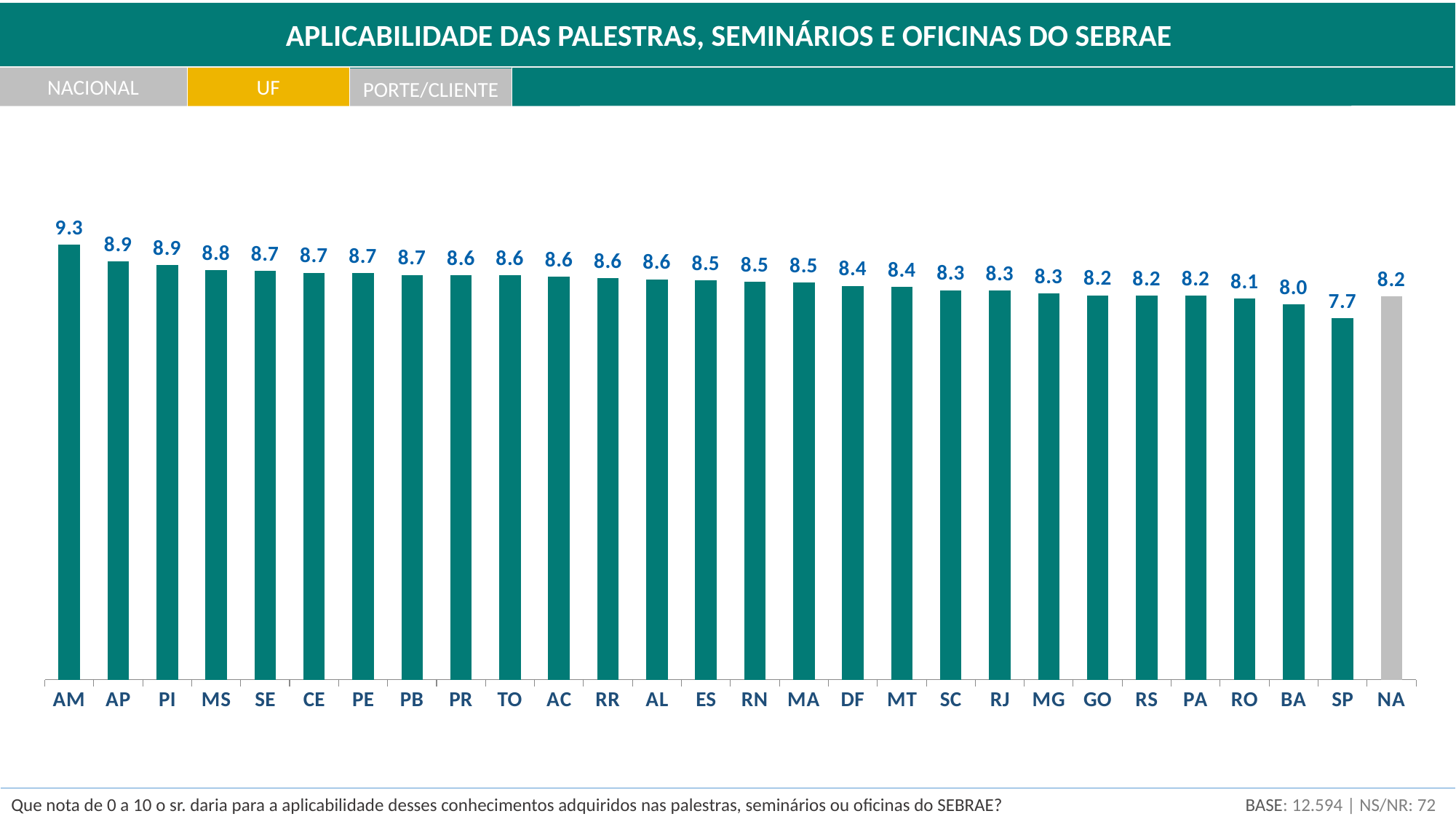
What is the value for AM? 9.3 What is the difference between the values for AP and BA? 0.9 How many bars are shown in the chart? 28 Which is larger, the value for MS or the value for RO? MS What is the value for the NA bar? 8.2 What is the value for DF? 8.4 Which category has the highest value? AM What is the difference between the values for AM and SP? 1.6 What is the value for SP? 7.7 Which bar is shown in grey instead of green? NA What kind of chart is shown on the slide? Bar chart Which category has the lowest value? SP